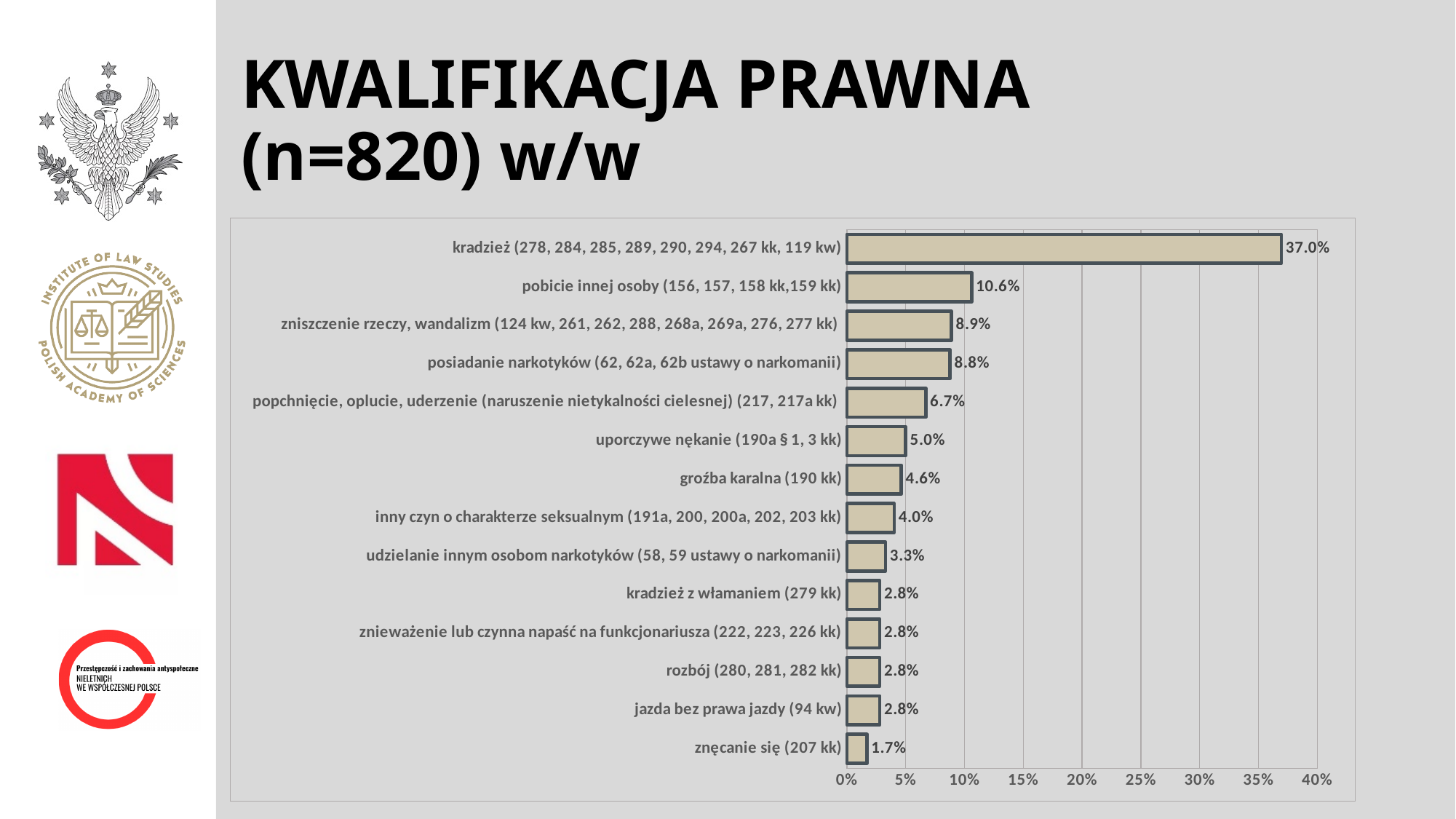
What is the maximum value shown on the horizontal axis? 40% Which category has the lowest value? znęcanie się (207 kk) Which is larger: the value for zniszczenie rzeczy, wandalizm or the value for popchnięcie, oplucie, uderzenie? zniszczenie rzeczy, wandalizm What is the value for kradzież (278, 284, 285, 289, 290, 294, 267 kk, 119 kw)? 37.0% Is the value for pobicie innej osoby (156, 157, 158 kk,159 kk) greater or less than 10%? greater What is the difference between the values for uporczywe nękanie (190a § 1, 3 kk) and znęcanie się (207 kk)? 3.3% What kind of chart is shown on the slide? bar chart What is the value for posiadanie narkotyków (62, 62a, 62b ustawy o narkomanii)? 8.8% How many categories are shown in the chart? 14 What is the difference between the values for kradzież and pobicie innej osoby? 26.4% Which category has the highest value? kradzież (278, 284, 285, 289, 290, 294, 267 kk, 119 kw) What is the value for groźba karalna (190 kk)? 4.6%